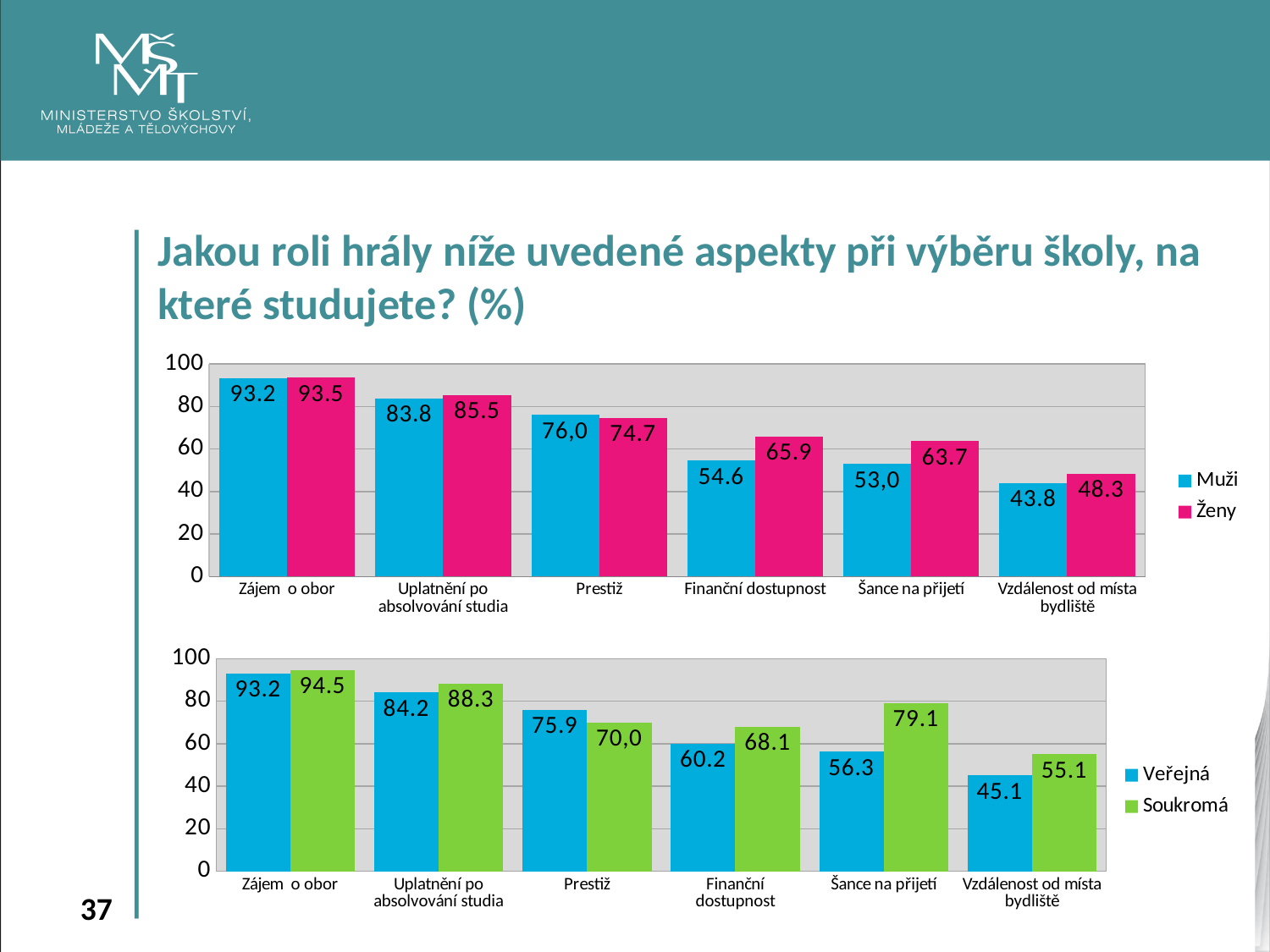
In the top chart (Muži/Ženy), what is the value for Muži for Prestiž? 76,0 What kind of chart is the top chart (Muži/Ženy)? Bar chart In the bottom chart (Veřejná/Soukromá), what is the difference between Veřejná and Soukromá for Prestiž? 5.9 In the bottom chart (Veřejná/Soukromá), what is the value for Veřejná for Vzdálenost od místa bydliště? 45.1 In the top chart (Muži/Ženy), what is the difference between Ženy and Muži for Šance na přijetí? 10.7 How many series does the legend of the bottom chart (Veřejná/Soukromá) list? 2 In the bottom chart (Veřejná/Soukromá), which is larger for Finanční dostupnost, Veřejná or Soukromá? Soukromá In the bottom chart (Veřejná/Soukromá), which category has the highest value for Soukromá? Zájem o obor How many categories are shown on the x axis of the top chart (Muži/Ženy)? 6 In the bottom chart (Veřejná/Soukromá), what is the value for Soukromá for Šance na přijetí? 79.1 In the top chart (Muži/Ženy), what is the value for Ženy for Finanční dostupnost? 65.9 In the top chart (Muži/Ženy), which category has the lowest value for Muži? Vzdálenost od místa bydliště